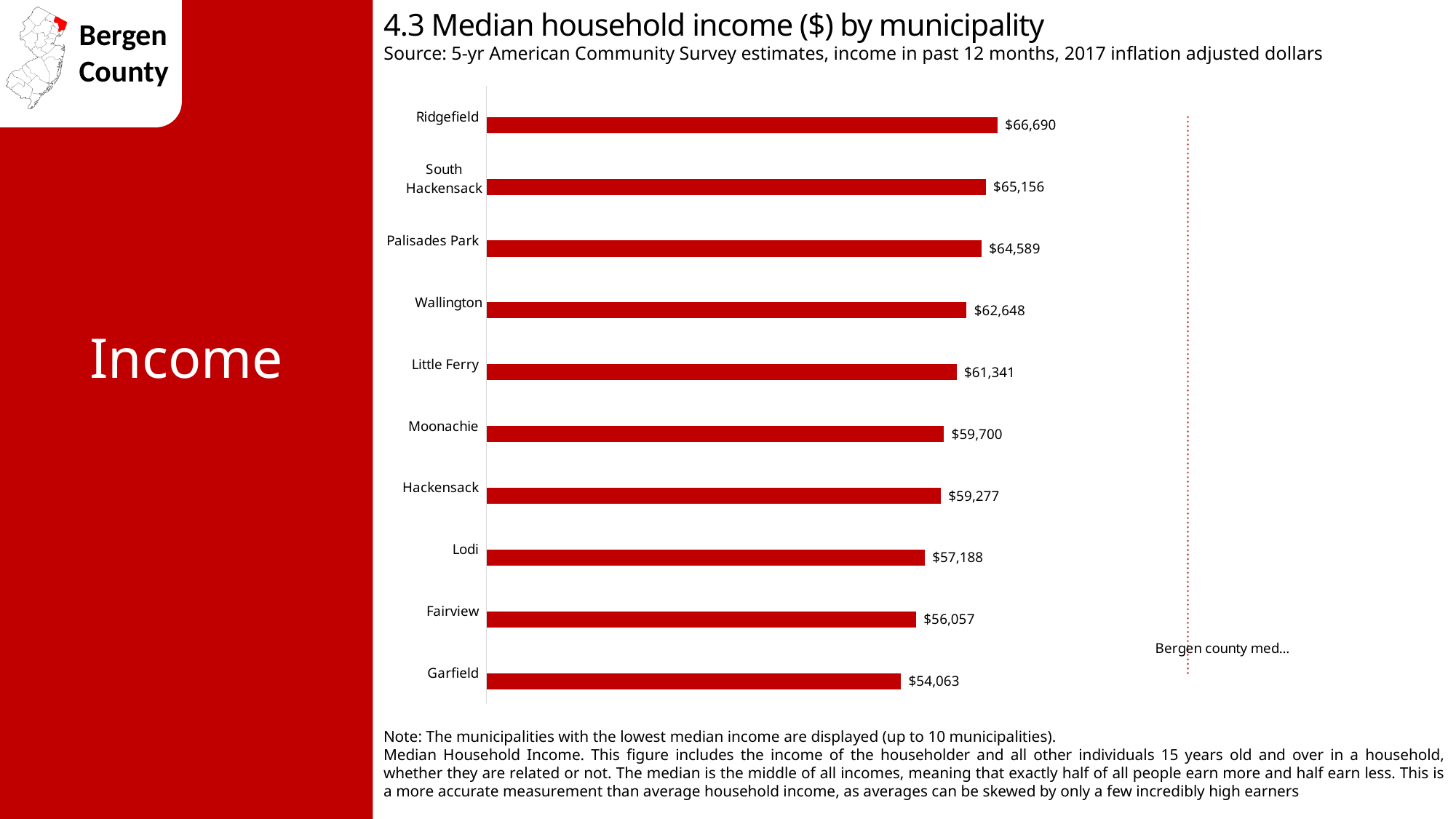
What is the median household income for Lodi? $57,188 Which municipality has the lowest median household income on the chart? Garfield What is the median household income for Garfield? $54,063 What is the difference between the median household income of Wallington and Little Ferry? $1,307 What is the title of the chart? 4.3 Median household income ($) by municipality How many municipalities are shown on the chart? 10 What is the median household income for Ridgefield? $66,690 What is the difference between the median household income of Ridgefield and Garfield? $12,627 What is the median household income for Hackensack? $59,277 Which has a higher median household income, Moonachie or Fairview? Moonachie Which municipality has the highest median household income on the chart? Ridgefield What type of chart is used on this slide? Bar chart